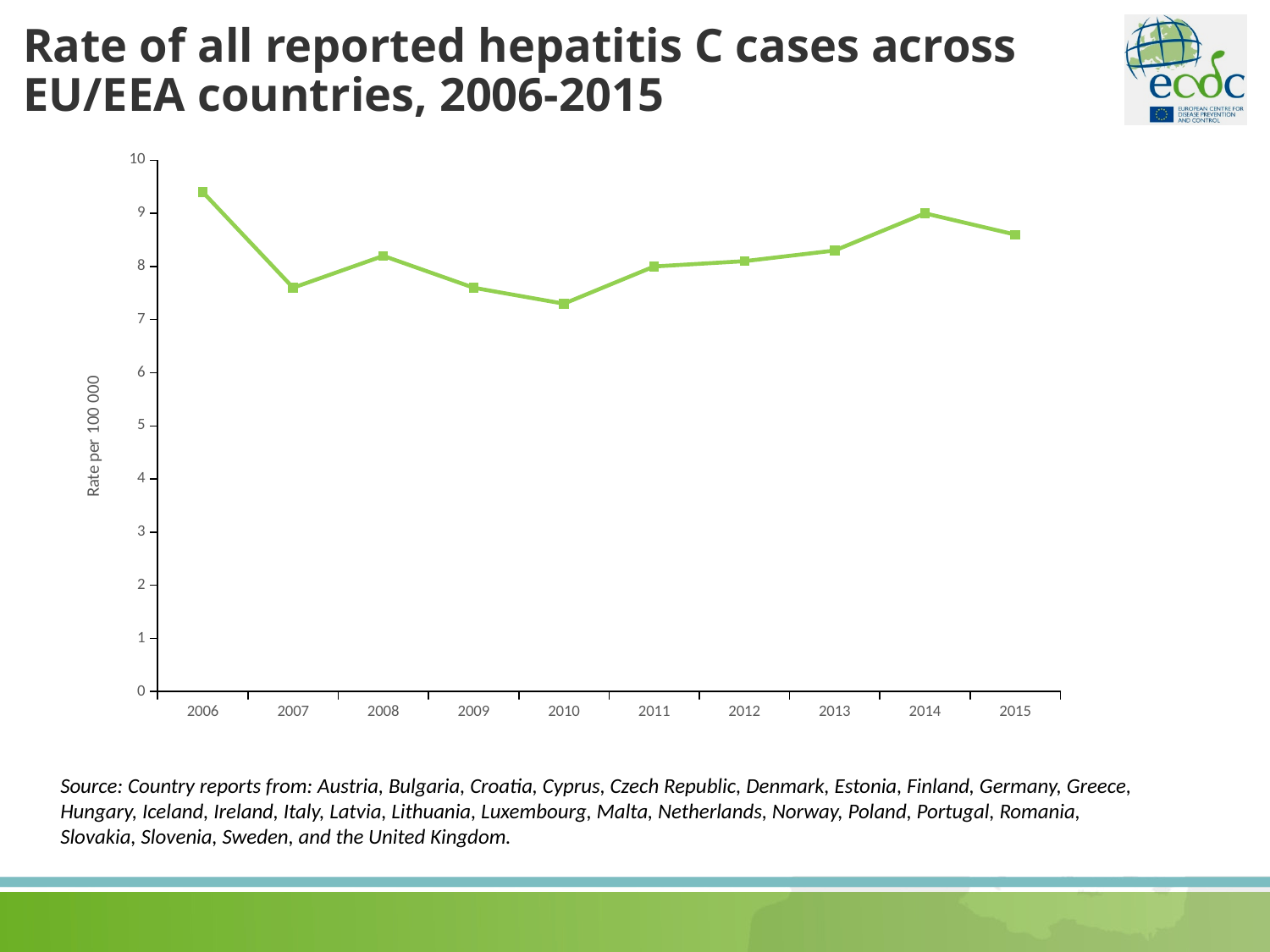
Which year has the larger rate, 2006 or 2015? 2006 Is the rate for 2007 greater or less than 8? less What is the label on the y axis? Rate per 100 000 Which year has the larger rate, 2010 or 2014? 2014 Is the rate for 2006 greater or less than 9? greater What kind of chart is shown on the slide? line chart Which year has the lowest rate of reported hepatitis C cases? 2010 Is the rate for 2015 greater or less than 8? greater How many years are plotted on the x axis? 10 Does the rate rise or fall from 2010 to 2014? rise Which year has the highest rate of reported hepatitis C cases? 2006